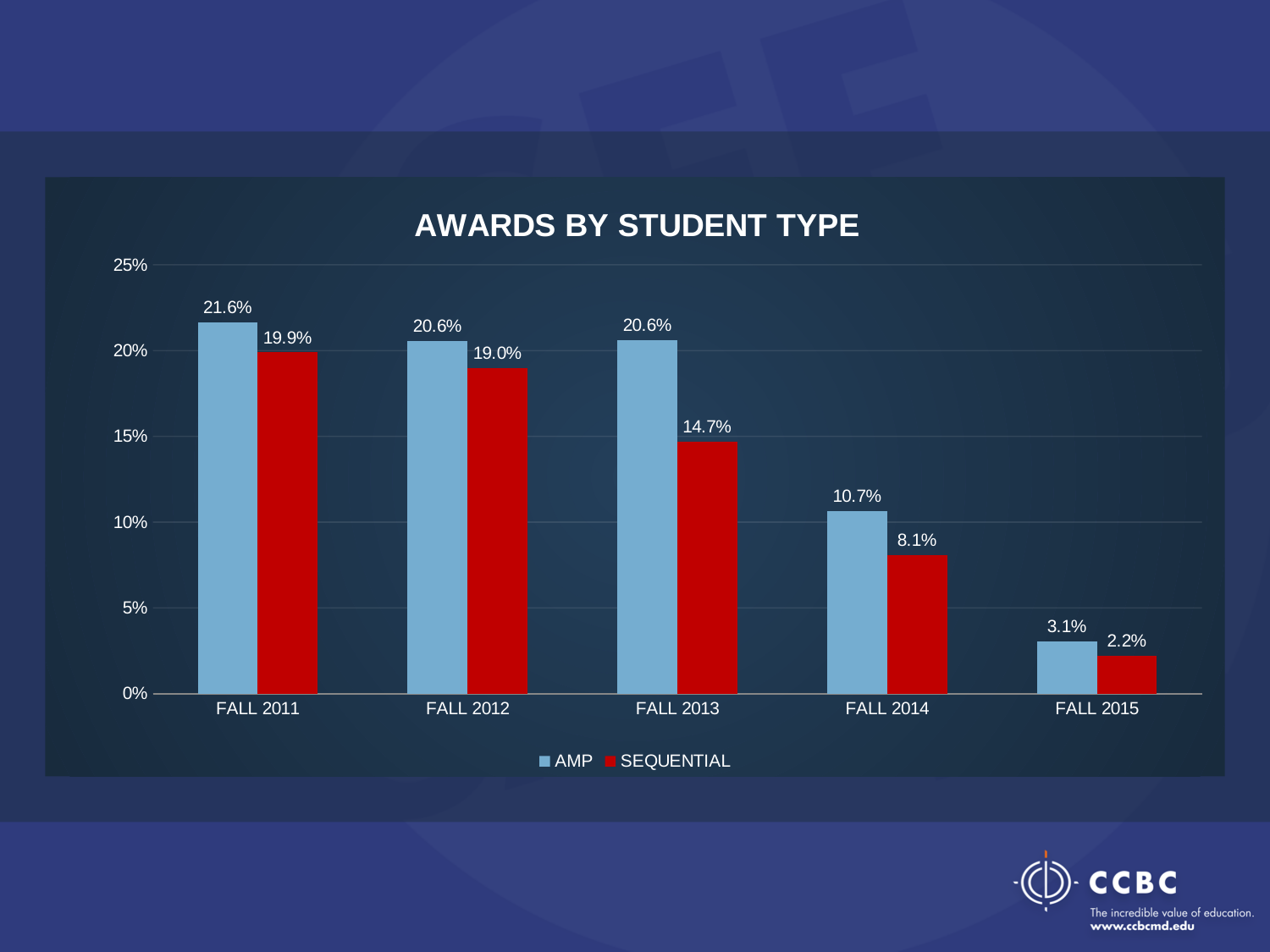
Which term has the highest AMP value? FALL 2011 What is the difference between the AMP and SEQUENTIAL values for FALL 2013? 5.9% Do the AMP values rise or fall from FALL 2011 to FALL 2015? Fall Is the SEQUENTIAL value for FALL 2012 greater or less than 15%? greater Which term has the lowest SEQUENTIAL value? FALL 2015 What is the SEQUENTIAL value for FALL 2013? 14.7% How many series does the legend list? 2 What is the AMP value for FALL 2011? 21.6% What kind of chart is shown on the slide? Bar chart How many terms are shown on the x axis? 5 Which is larger for FALL 2014, the AMP value or the SEQUENTIAL value? AMP What is the AMP value for FALL 2014? 10.7%